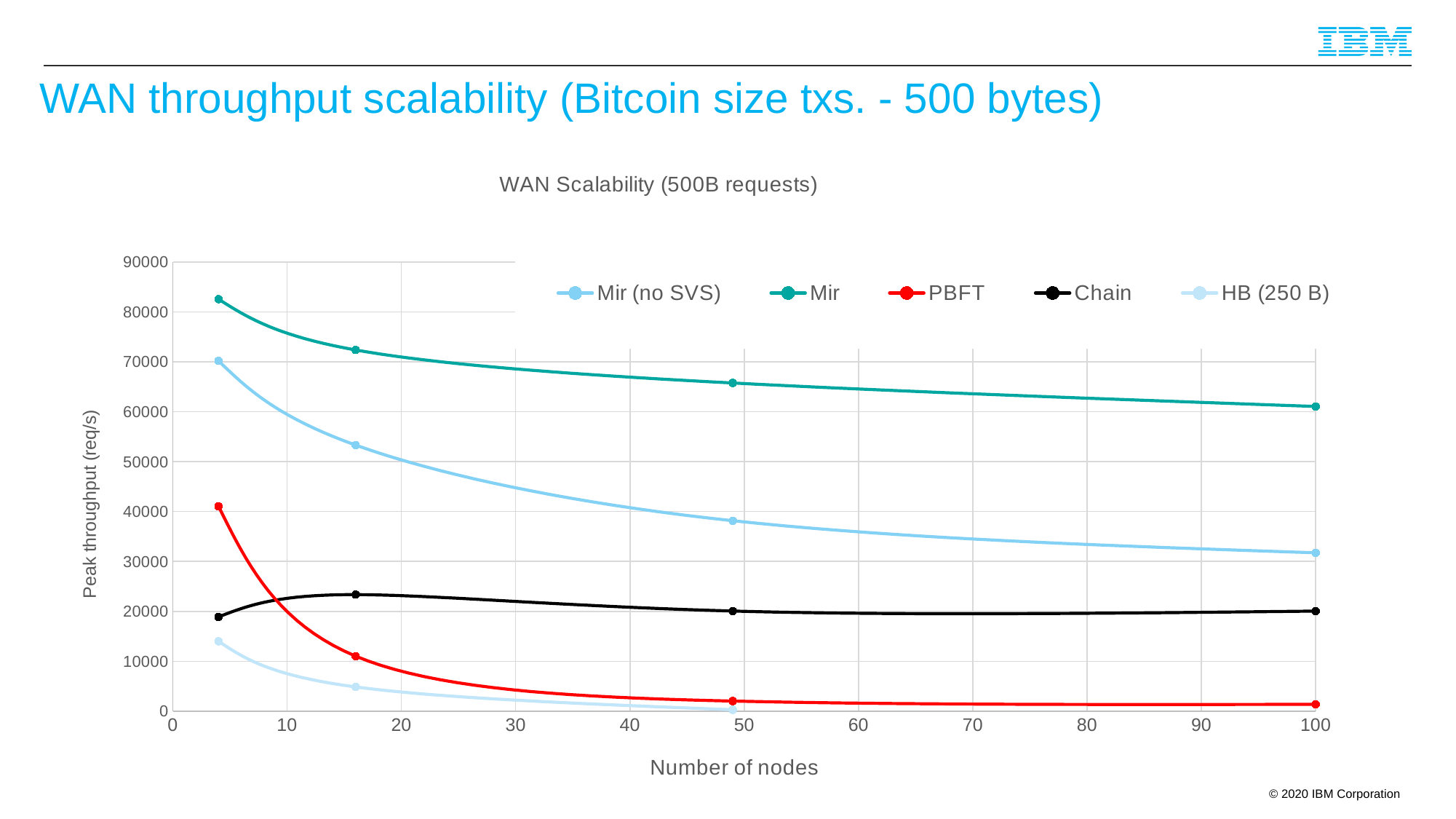
At 100 nodes, which series has the larger peak throughput, Chain or Mir (no SVS)? Mir (no SVS) What is the title of the chart? WAN Scalability (500B requests) What is the label of the y axis? Peak throughput (req/s) Is the value for PBFT at about 4 nodes greater or less than 30000? greater How many series does the legend list? 5 Is the value for Mir (no SVS) at 100 nodes greater or less than 40000? less Is the value for Chain at 100 nodes greater or less than 10000? greater Does the peak throughput for PBFT rise or fall as the number of nodes increases? fall What kind of chart is shown on the slide? line chart Which series has the lowest peak throughput at 100 nodes? PBFT Which series has the highest peak throughput at 100 nodes? Mir